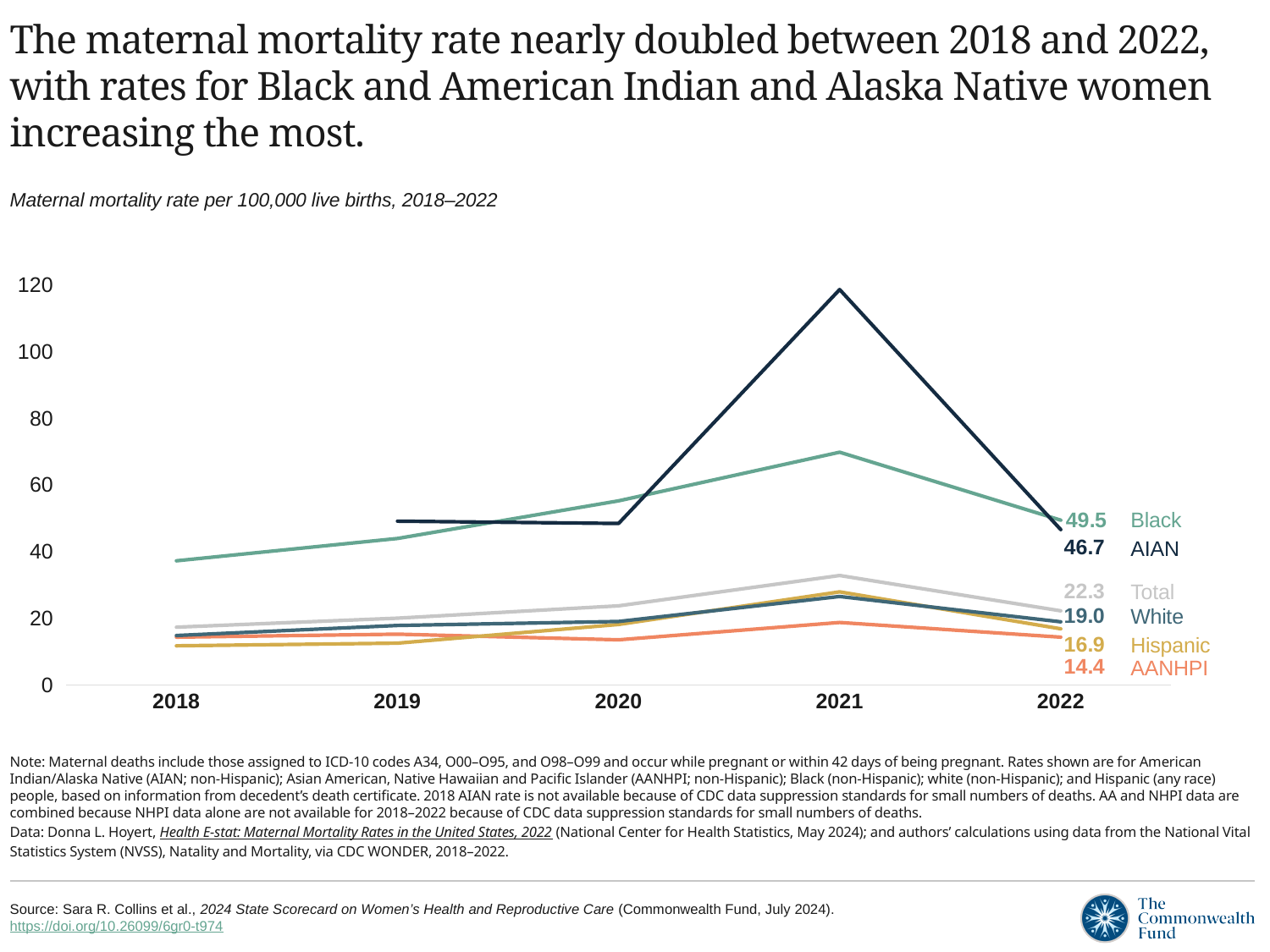
Which group has the lowest maternal mortality rate in 2022? AANHPI What is the maternal mortality rate for AANHPI women in 2022? 14.4 How many years are shown on the x axis? 5 What is the maternal mortality rate for Black women in 2022? 49.5 What is the Total maternal mortality rate in 2022? 22.3 In 2022, is the rate for White women or Hispanic women higher? White What type of chart is shown on the slide? Line chart Is the AIAN rate in 2021 greater or less than 100? greater Which group has the highest maternal mortality rate in 2021? AIAN How many series are plotted on the chart? 6 What is the maternal mortality rate for AIAN women in 2022? 46.7 What is the difference between the 2022 rates for Black and AIAN women? 2.8